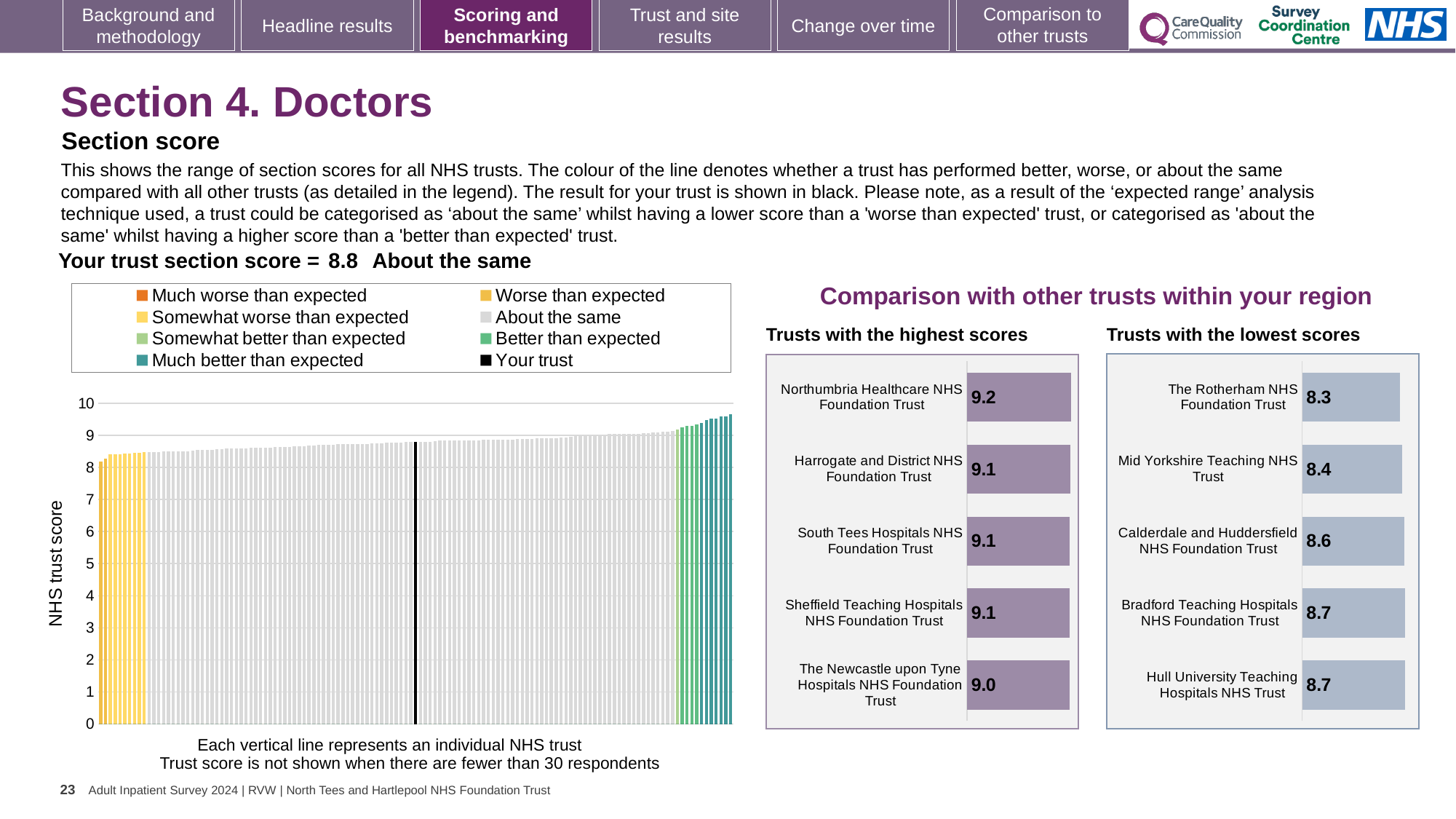
How many entries does the legend of the large chart on the left list? 8 In the 'Trusts with the lowest scores' chart, what is the score for Calderdale and Huddersfield NHS Foundation Trust? 8.6 In the 'Trusts with the lowest scores' chart, what is the difference between the scores of Hull University Teaching Hospitals NHS Trust and The Rotherham NHS Foundation Trust? 0.4 In the 'Trusts with the highest scores' chart, what is the score for Northumbria Healthcare NHS Foundation Trust? 9.2 In the 'Trusts with the lowest scores' chart, what is the score for The Rotherham NHS Foundation Trust? 8.3 What kind of chart is the large chart on the left showing NHS trust scores? Bar chart In the 'Trusts with the highest scores' chart, which trust has the highest score? Northumbria Healthcare NHS Foundation Trust In the large chart on the left, do the NHS trust scores rise or fall from left to right along the x axis? Rise In the 'Trusts with the highest scores' chart, what is the score for Harrogate and District NHS Foundation Trust? 9.1 In the 'Trusts with the highest scores' chart, which has the larger score: Northumbria Healthcare NHS Foundation Trust or The Newcastle upon Tyne Hospitals NHS Foundation Trust? Northumbria Healthcare NHS Foundation Trust In the 'Trusts with the lowest scores' chart, which trust has the lowest score? The Rotherham NHS Foundation Trust In the 'Trusts with the lowest scores' chart, how many trusts are listed? 5